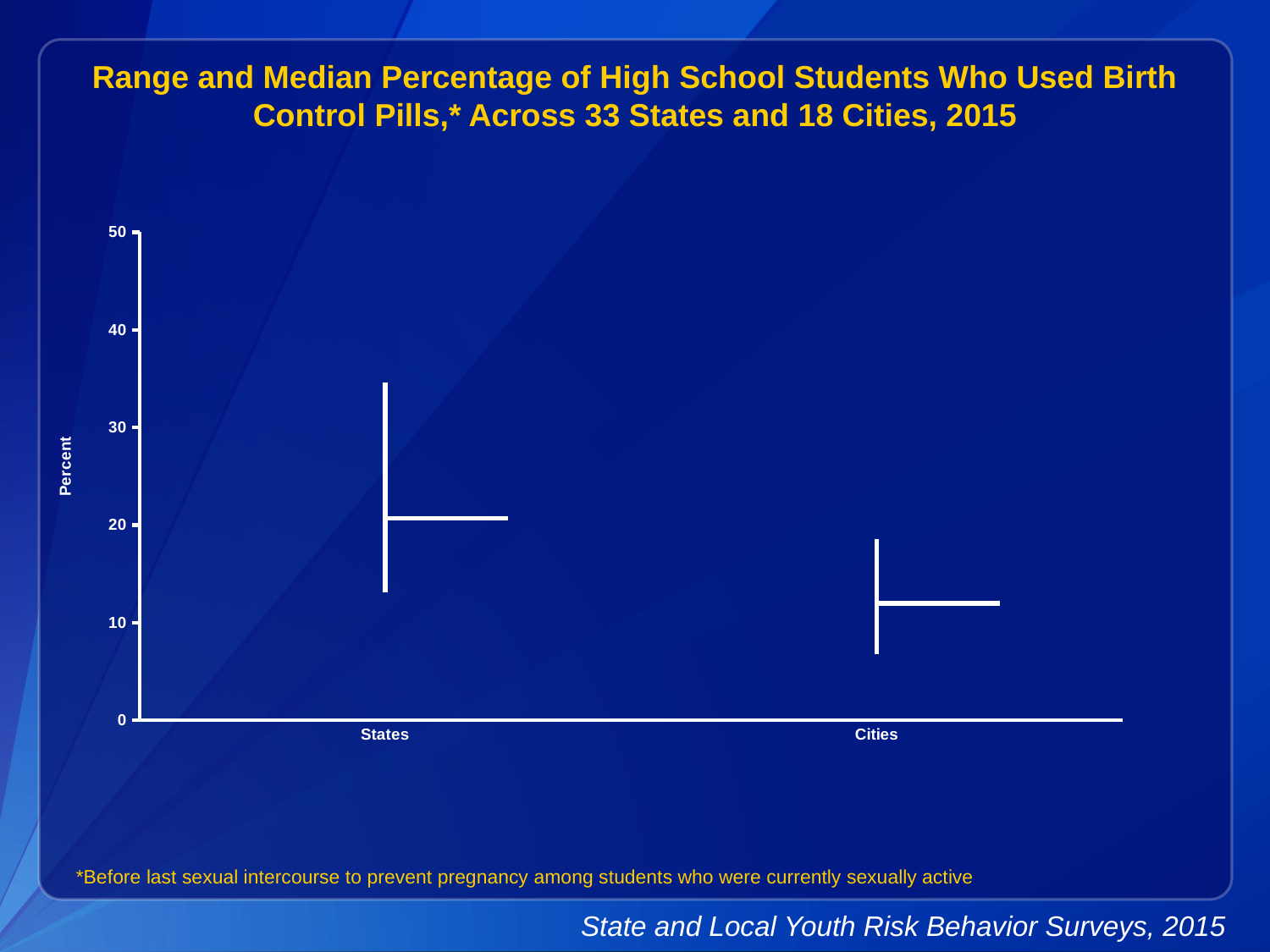
Is the median value for States greater or less than 10? greater Is the bottom of the range for States greater or less than 10? greater Is the median value for Cities greater or less than 20? less How many categories are shown on the x axis of the chart? 2 Which category has the higher median percentage, States or Cities? States What is the highest value shown on the y axis? 50 Which category has the lower median percentage? Cities What is the label on the y axis of the chart? Percent Which category has the higher top of its range, States or Cities? States